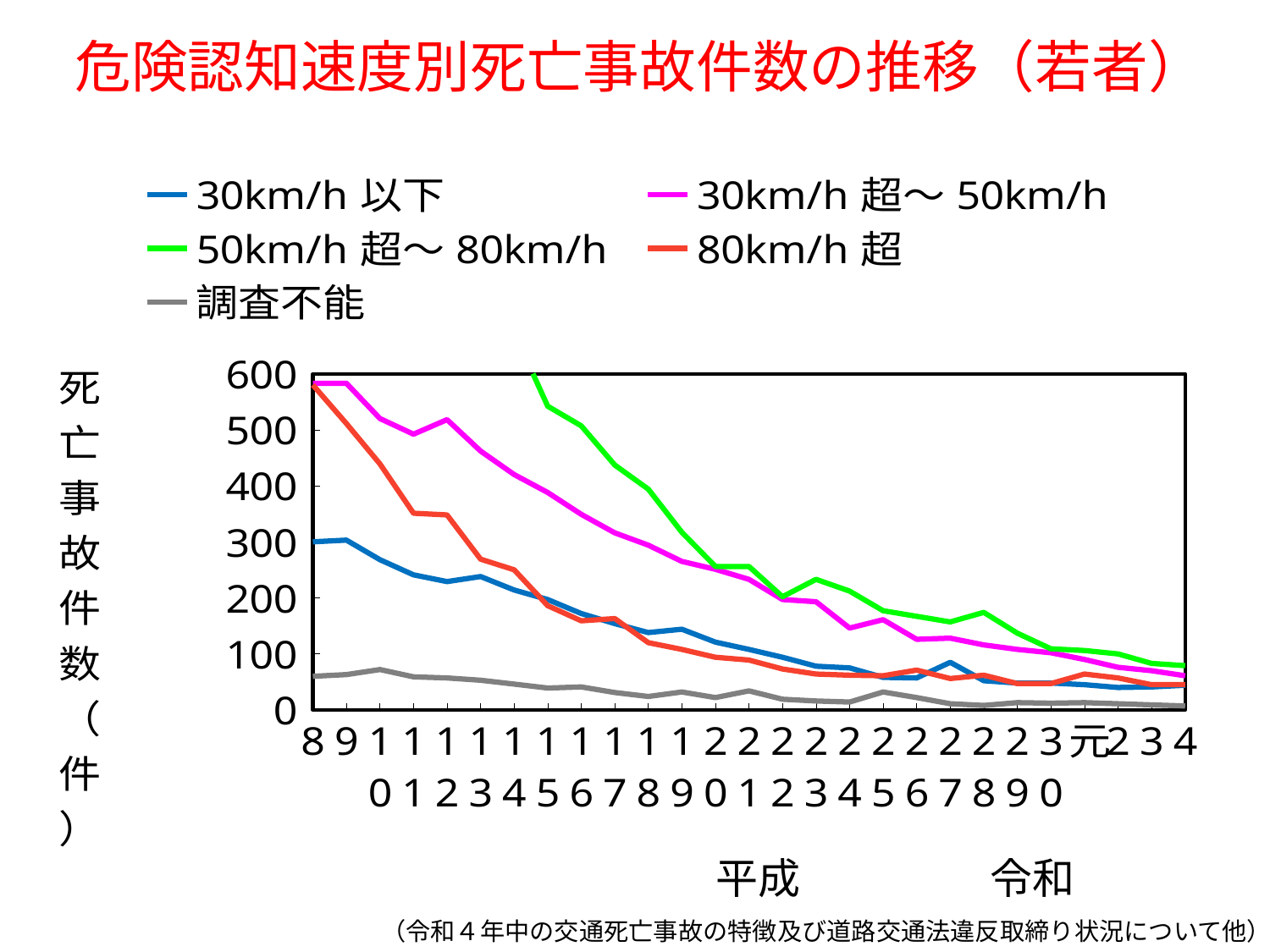
In 平成8, which series has the lowest value? 調査不能 What is the title of the chart? 危険認知速度別死亡事故件数の推移（若者） In 平成8, which is larger: the value for 30km/h 超～ 50km/h or the value for 30km/h 以下? 30km/h 超～ 50km/h Is the value for 30km/h 超～ 50km/h in 平成16 greater or less than 300? greater Is the value for 50km/h 超～ 80km/h in 令和4 greater or less than 100? less Do the values for 30km/h 超～ 50km/h rise or fall from 平成8 to 令和4? fall Is the value for 80km/h 超 in 平成8 greater or less than 500? greater What is the label on the vertical axis? 死亡事故件数（件） In 平成16, which series has the highest value? 50km/h 超～ 80km/h How many series does the legend list? 5 What kind of chart is shown on the slide? line chart